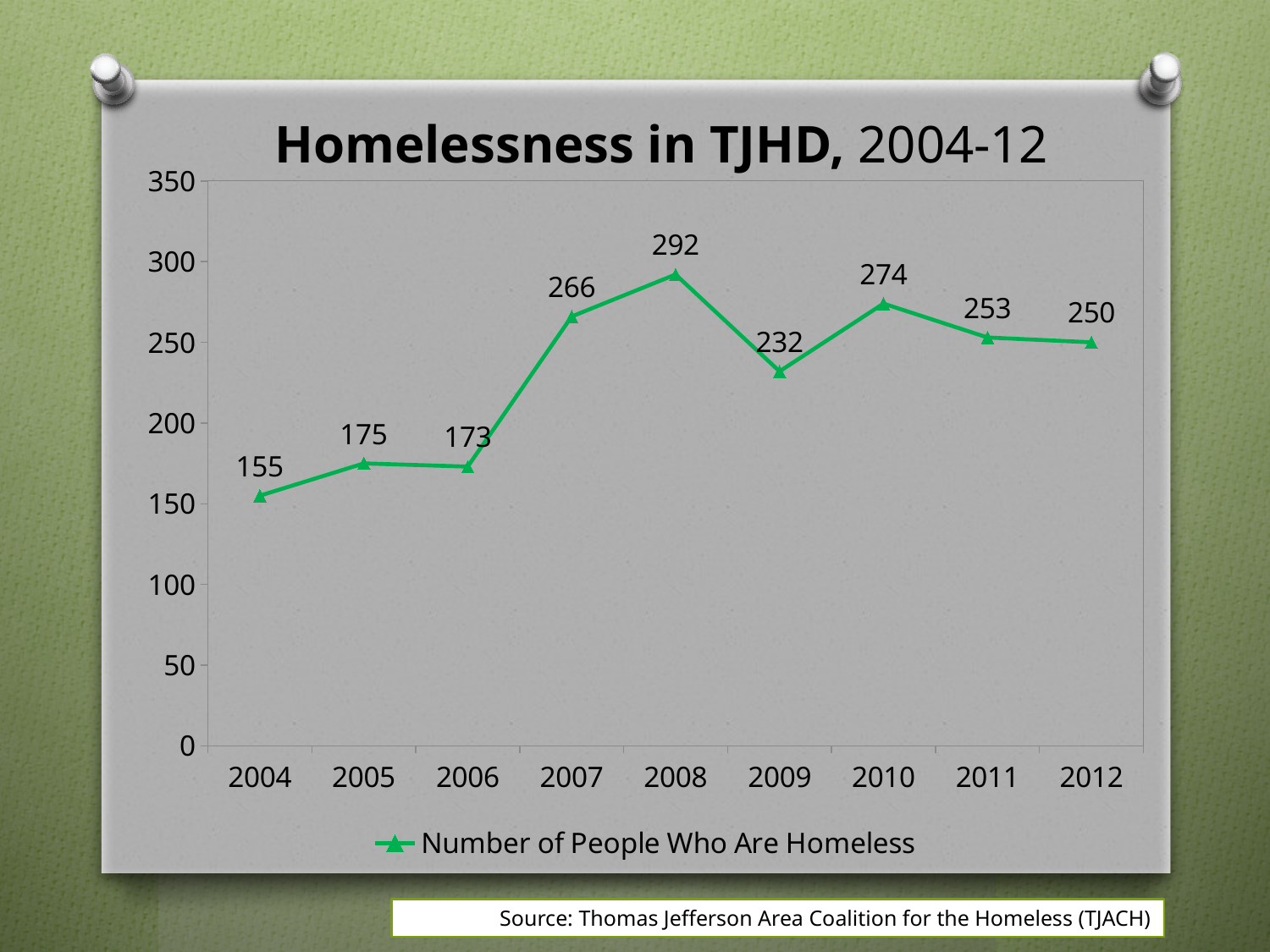
What kind of chart is shown on the slide? Line chart What was the number of people who are homeless in 2008? 292 Which year had the highest number of people who are homeless? 2008 What is the difference between the 2008 and 2009 values? 60 What is the difference between the 2007 and 2006 values? 93 Which year had a larger value, 2011 or 2009? 2011 How many series does the legend list? 1 How many years are plotted on the chart? 9 What was the number of people who are homeless in 2004? 155 Did the number of people who are homeless rise or fall from 2010 to 2012? Fall What was the number of people who are homeless in 2010? 274 Which year had the lowest number of people who are homeless? 2004